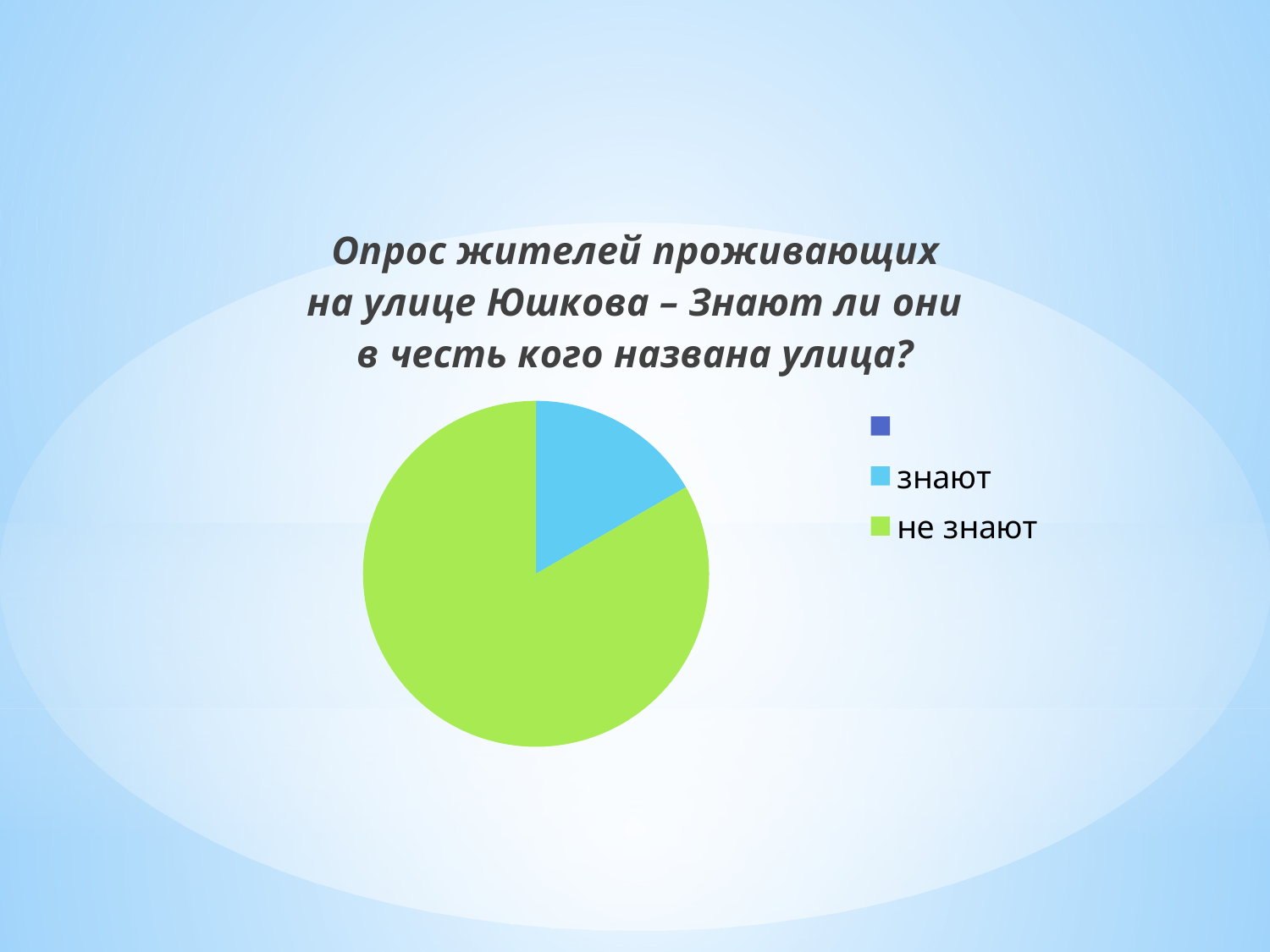
What colour is the "не знают" slice? green Which category has the largest slice of the pie? не знают Which category has the smallest slice of the pie? знают What colour is the "знают" slice? blue What kind of chart is shown on the slide? pie chart Which slice is larger, "знают" or "не знают"? не знают How many slices are visible in the pie chart? 2 How many labelled entries does the legend list? 2